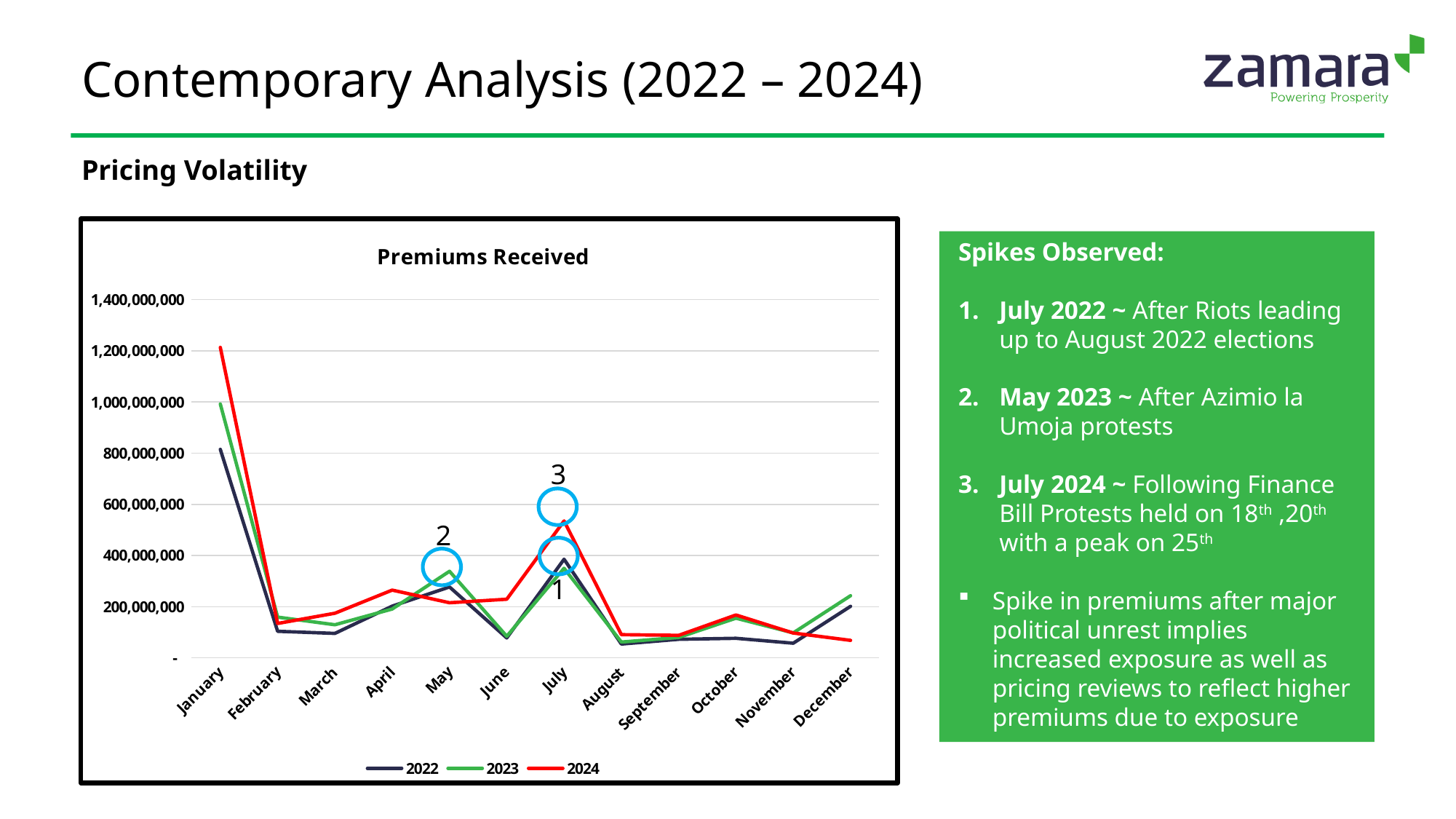
Which month has the highest value for the 2024 series? January How many months are shown along the x axis of the chart? 12 Is the value for January in the 2022 series greater or less than 1,000,000,000? less How many series does the chart legend list? 3 Is the value for June in the 2023 series greater or less than 200,000,000? less What is the title of the chart? Premiums Received What type of chart is shown on the slide? Line chart Is the value for January in the 2024 series greater or less than 1,000,000,000? greater Do the values rise or fall from January to February for all three series? fall In January, which series has the larger value, 2022 or 2024? 2024 In May, which series has the highest value? 2023